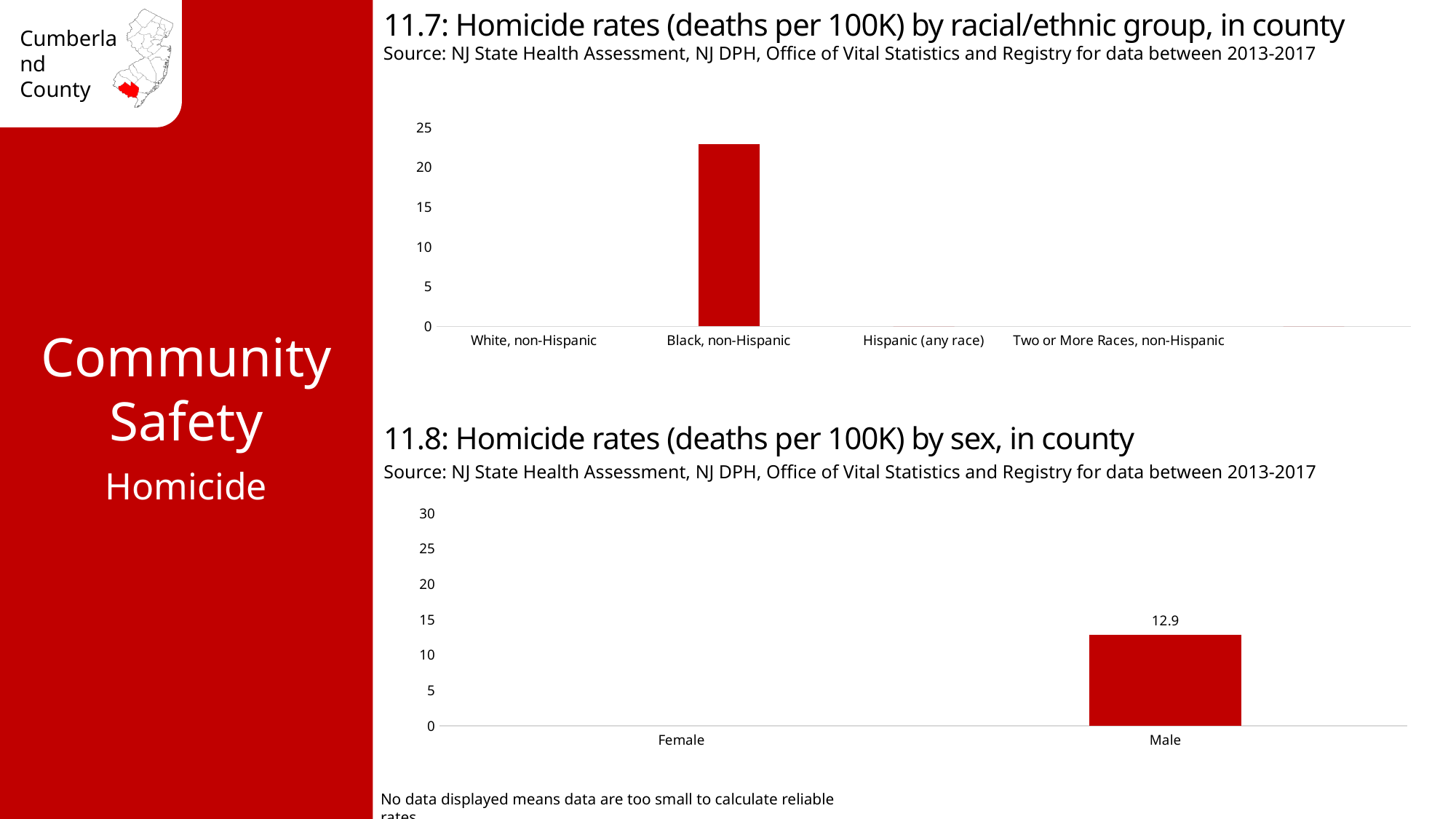
In the chart '11.7: Homicide rates (deaths per 100K) by racial/ethnic group, in county', what kind of chart is shown? bar chart In the chart '11.7: Homicide rates (deaths per 100K) by racial/ethnic group, in county', which is the only racial/ethnic group with a bar displayed? Black, non-Hispanic In the chart '11.8: Homicide rates (deaths per 100K) by sex, in county', which sex has the higher homicide rate shown? Male In the chart '11.7: Homicide rates (deaths per 100K) by racial/ethnic group, in county', is the value for Black, non-Hispanic greater or less than 20? greater In the chart '11.7: Homicide rates (deaths per 100K) by racial/ethnic group, in county', is the value for Black, non-Hispanic greater or less than 25? less In the chart '11.7: Homicide rates (deaths per 100K) by racial/ethnic group, in county', which racial/ethnic group has the highest homicide rate shown? Black, non-Hispanic In the chart '11.8: Homicide rates (deaths per 100K) by sex, in county', what kind of chart is shown? bar chart In the chart '11.7: Homicide rates (deaths per 100K) by racial/ethnic group, in county', how many racial/ethnic group categories are listed on the x axis? 4 In the chart '11.8: Homicide rates (deaths per 100K) by sex, in county', what is the homicide rate for Male? 12.9 In the chart '11.8: Homicide rates (deaths per 100K) by sex, in county', is the value for Male greater or less than 10? greater In the chart '11.8: Homicide rates (deaths per 100K) by sex, in county', how many sex categories are shown on the x axis? 2 In the chart '11.8: Homicide rates (deaths per 100K) by sex, in county', what is the highest value shown on the y axis? 30